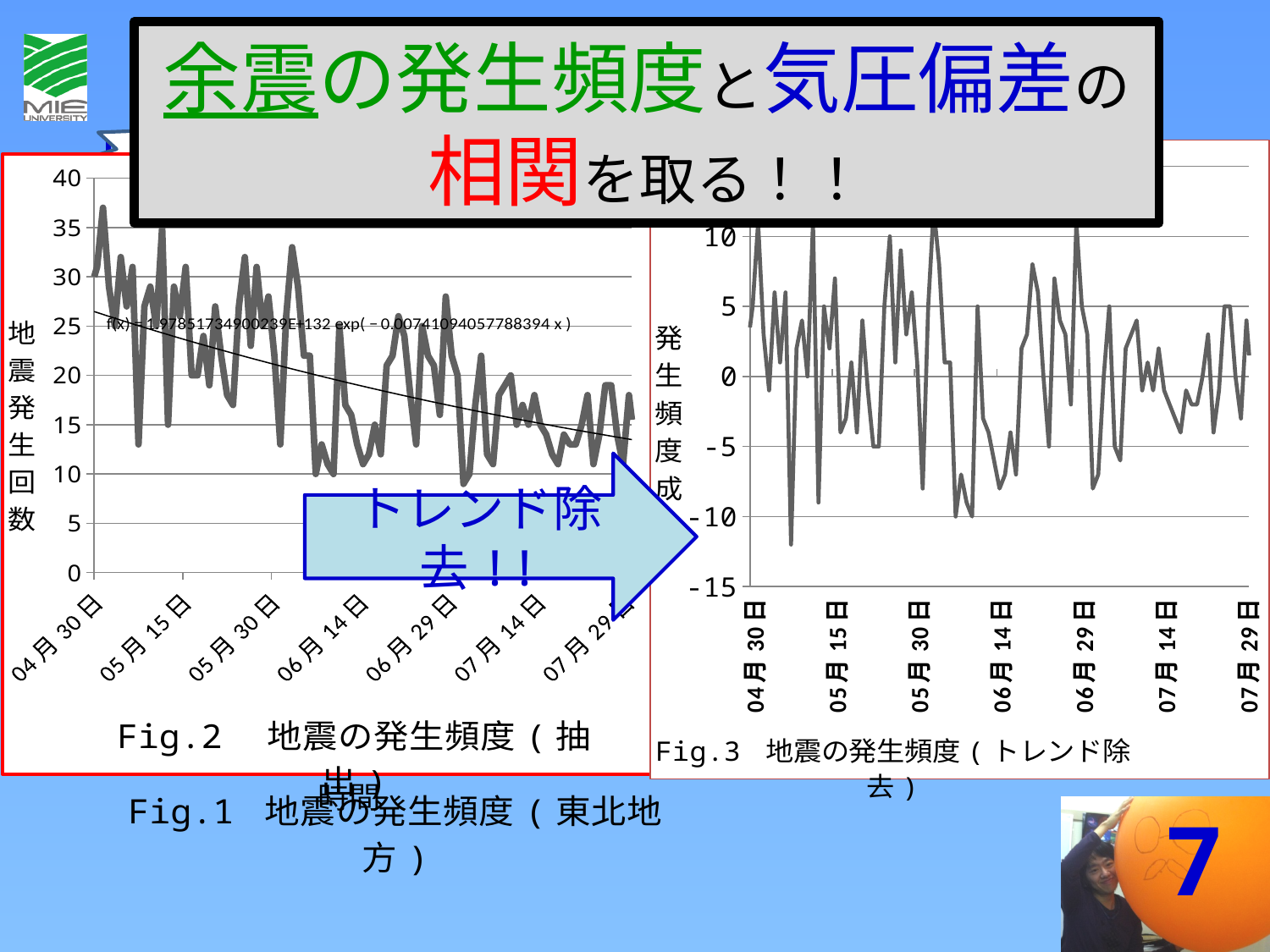
In Fig.2 (the left chart), is the highest plotted value greater or less than 35? greater How many date labels are shown on the x axis of Fig.3 (the right chart)? 7 What kind of chart is Fig.3 (the right chart)? line chart In Fig.2 (the left chart), is the lowest plotted value greater or less than 15? less In Fig.3 (the right chart), what is the lowest value shown on the y axis? -15 In Fig.2 (the left chart), do the values generally rise or fall from 04月30日 to 07月29日? fall What kind of chart is Fig.2 (the left chart)? line chart In Fig.2 (the left chart), what is the highest value shown on the y axis? 40 In Fig.2 (the left chart), does the fitted trend line rise or fall along the x axis? fall In Fig.3 (the right chart), is the lowest plotted value greater or less than -10? less